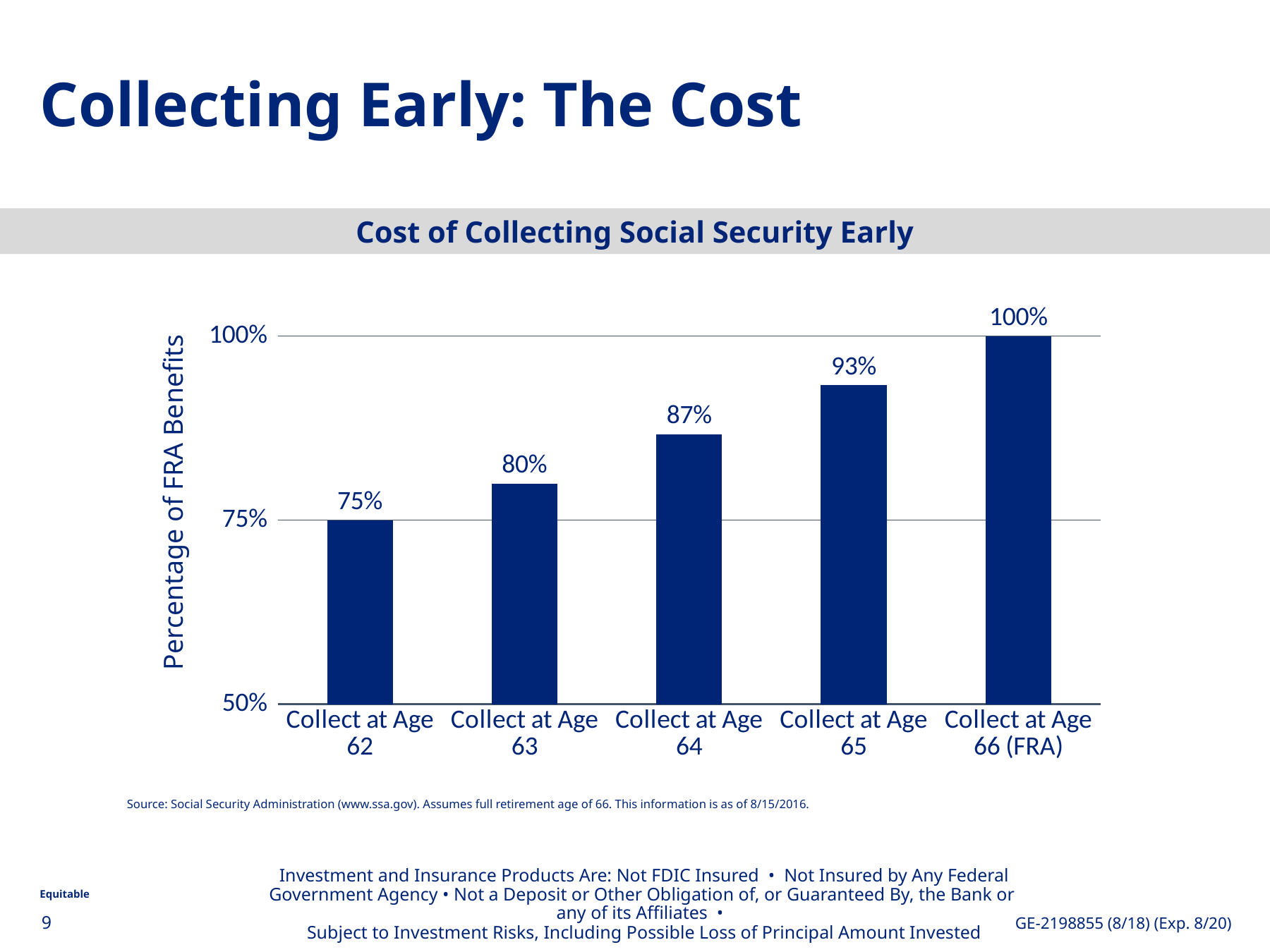
Do the values rise or fall from Collect at Age 62 to Collect at Age 66 (FRA)? Rise What percentage of FRA benefits is shown for Collect at Age 65? 93% What percentage of FRA benefits is shown for Collect at Age 62? 75% How many categories are shown on the x axis? 5 What is the difference in percentage points between Collect at Age 64 and Collect at Age 63? 7 What kind of chart is shown on the slide? Bar chart Which category has the highest percentage of FRA benefits? Collect at Age 66 (FRA) Which is larger, the value for Collect at Age 63 or the value for Collect at Age 65? Collect at Age 65 Which category has the lowest percentage of FRA benefits? Collect at Age 62 What is the difference in percentage points between Collect at Age 66 (FRA) and Collect at Age 62? 25 What percentage of FRA benefits is shown for Collect at Age 64? 87% What is the title of the chart? Cost of Collecting Social Security Early